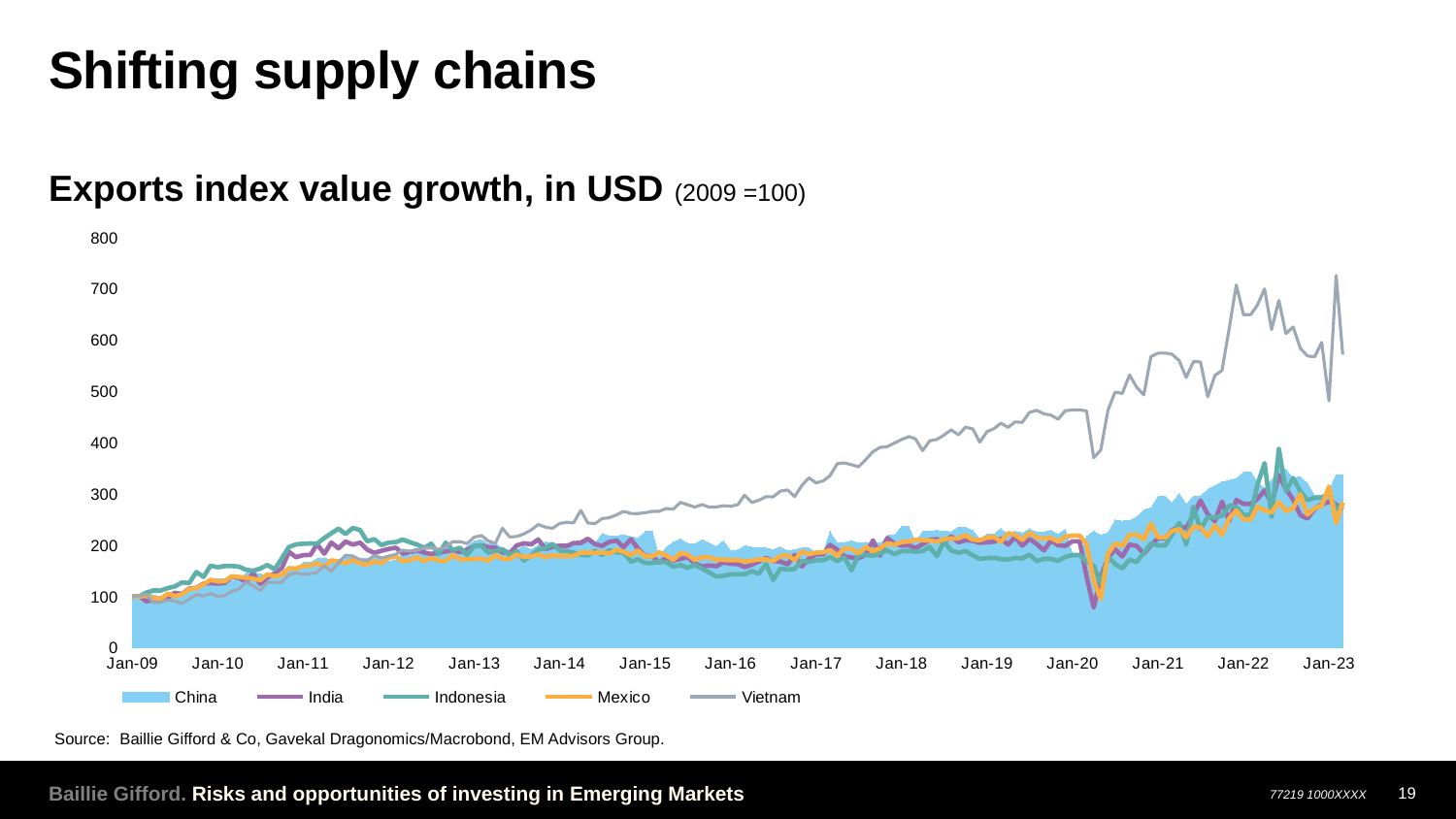
How many series does the legend list? 5 What is the title of the chart? Exports index value growth, in USD (2009 =100) Which is larger at Jan-17, the value for Vietnam or the value for Indonesia? Vietnam Does the value for Vietnam rise or fall overall from Jan-09 to Jan-23? rise Which series has the highest value at Jan-23? Vietnam Is the value for Indonesia at Jan-16 greater or less than 200? less Is the value for Vietnam at Jan-22 greater or less than 600? greater Which series is drawn as a shaded area rather than a line? China Is the value for Vietnam at Jan-20 greater or less than 500? less What is the index value for all series in the base year 2009? 100 How many year labels are shown on the x axis? 15